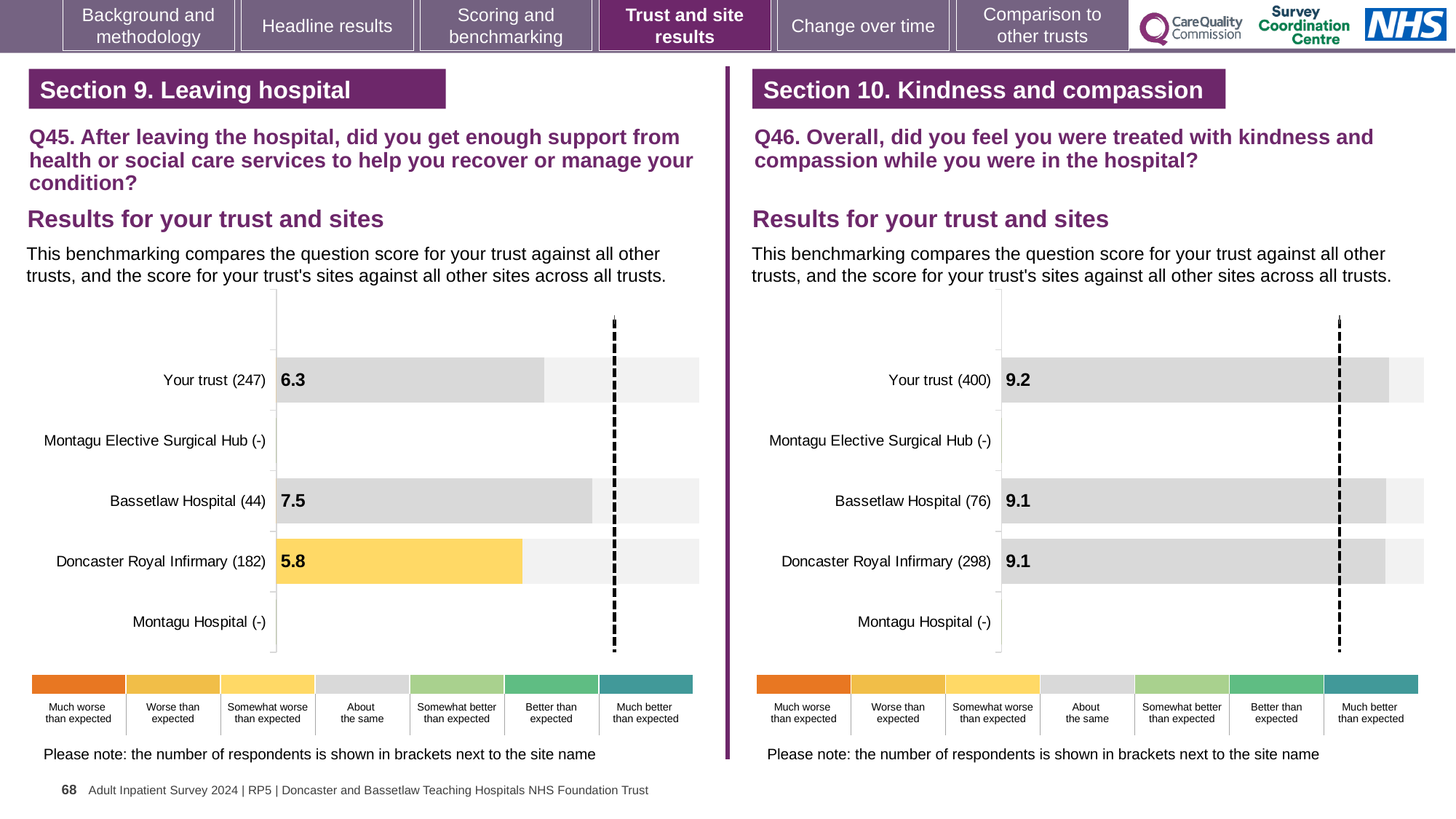
In the Q46 chart on the right, how many respondents are shown in brackets for Your trust? 400 In the Q46 chart on the right, what is the score for Your trust? 9.2 In the Q46 chart on the right, what is the score for Doncaster Royal Infirmary? 9.1 In the Q45 chart on the left, what is the difference between the Bassetlaw Hospital score and the Doncaster Royal Infirmary score? 1.7 What kind of chart is used on this slide to show the results for the trust and sites? bar chart In the Q45 chart on the left, what is the score for Your trust? 6.3 In the Q45 chart on the left, what is the score for Bassetlaw Hospital? 7.5 In the Q45 chart on the left, which bar is coloured yellow, indicating 'Somewhat worse than expected'? Doncaster Royal Infirmary In the Q46 chart on the right, is the score for Your trust larger or smaller than the score for Bassetlaw Hospital? larger In the Q45 chart on the left, which site has the highest score? Bassetlaw Hospital In the Q45 chart on the left, which site has the lowest score? Doncaster Royal Infirmary In the Q45 chart on the left, what is the score for Doncaster Royal Infirmary? 5.8